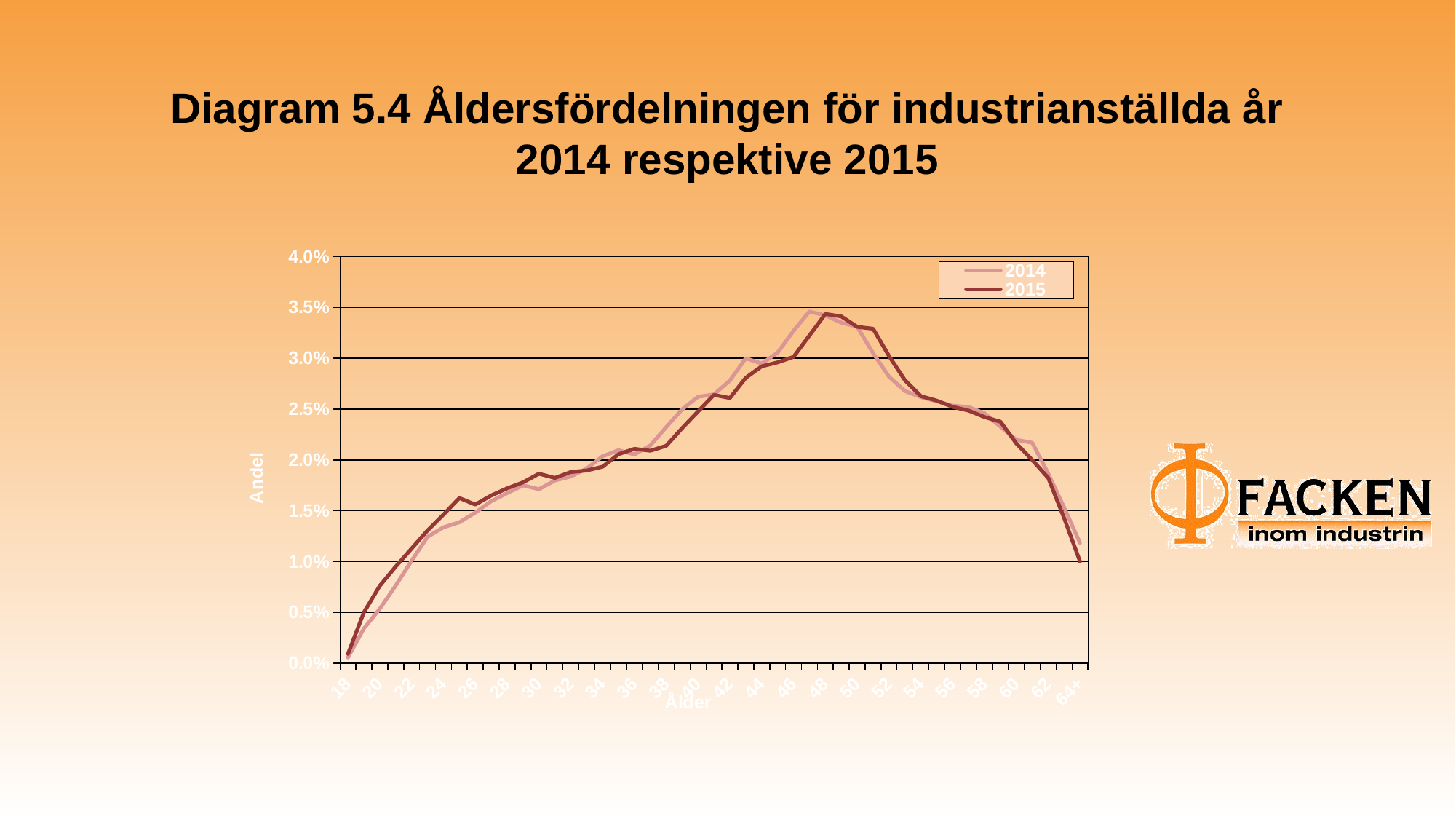
Is the value for 2015 at age 30 greater or less than 1.5%? greater Is the value for 2014 at age 64+ greater or less than 1.5%? less How many series does the legend list? 2 At age 20, which series has the higher value, 2014 or 2015? 2015 What kind of chart is shown on the slide? line chart Do the values for 2015 rise or fall between age 52 and age 64+? fall Is the value for 2015 at age 18 greater or less than 0.5%? less Which two series are listed in the legend? 2014 and 2015 What is the title of the y axis? Andel